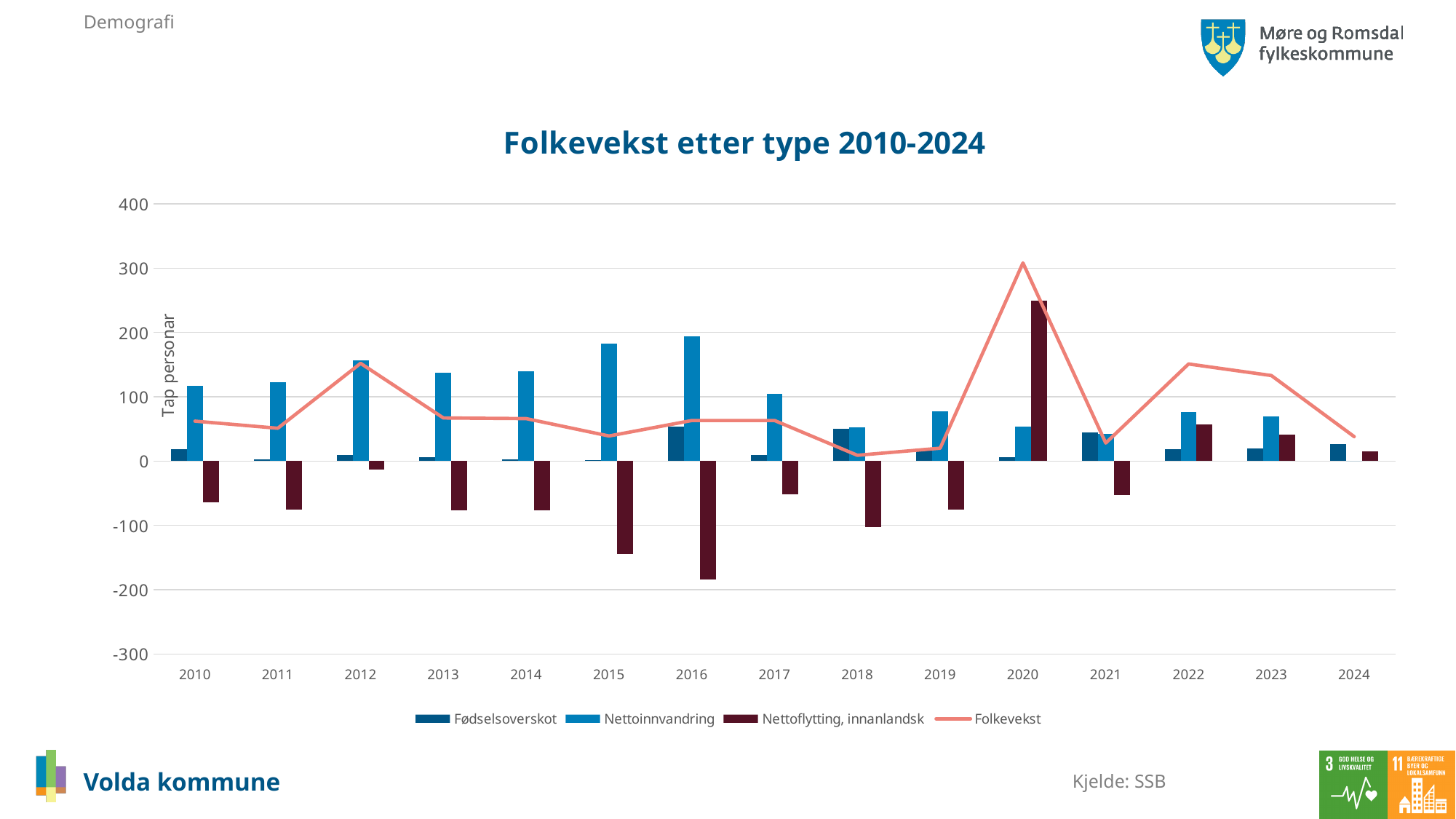
In which year is Nettoinnvandring highest? 2016 Is the value for Nettoflytting, innanlandsk in 2020 greater or less than 200? greater What kind of chart is shown on the slide? A bar chart combined with a line Is the value for Nettoinnvandring in 2016 greater or less than 150? greater How many series does the legend list? 4 Does the Folkevekst line rise or fall from 2020 to 2021? fall In which year is Nettoflytting, innanlandsk lowest? 2016 Is the value for Nettoflytting, innanlandsk in 2015 greater or less than -100? less What is the title of the chart? Folkevekst etter type 2010-2024 How many years are shown on the x axis? 15 Which is larger, Nettoinnvandring in 2015 or in 2017? 2015 In which year does the Folkevekst line reach its highest point? 2020